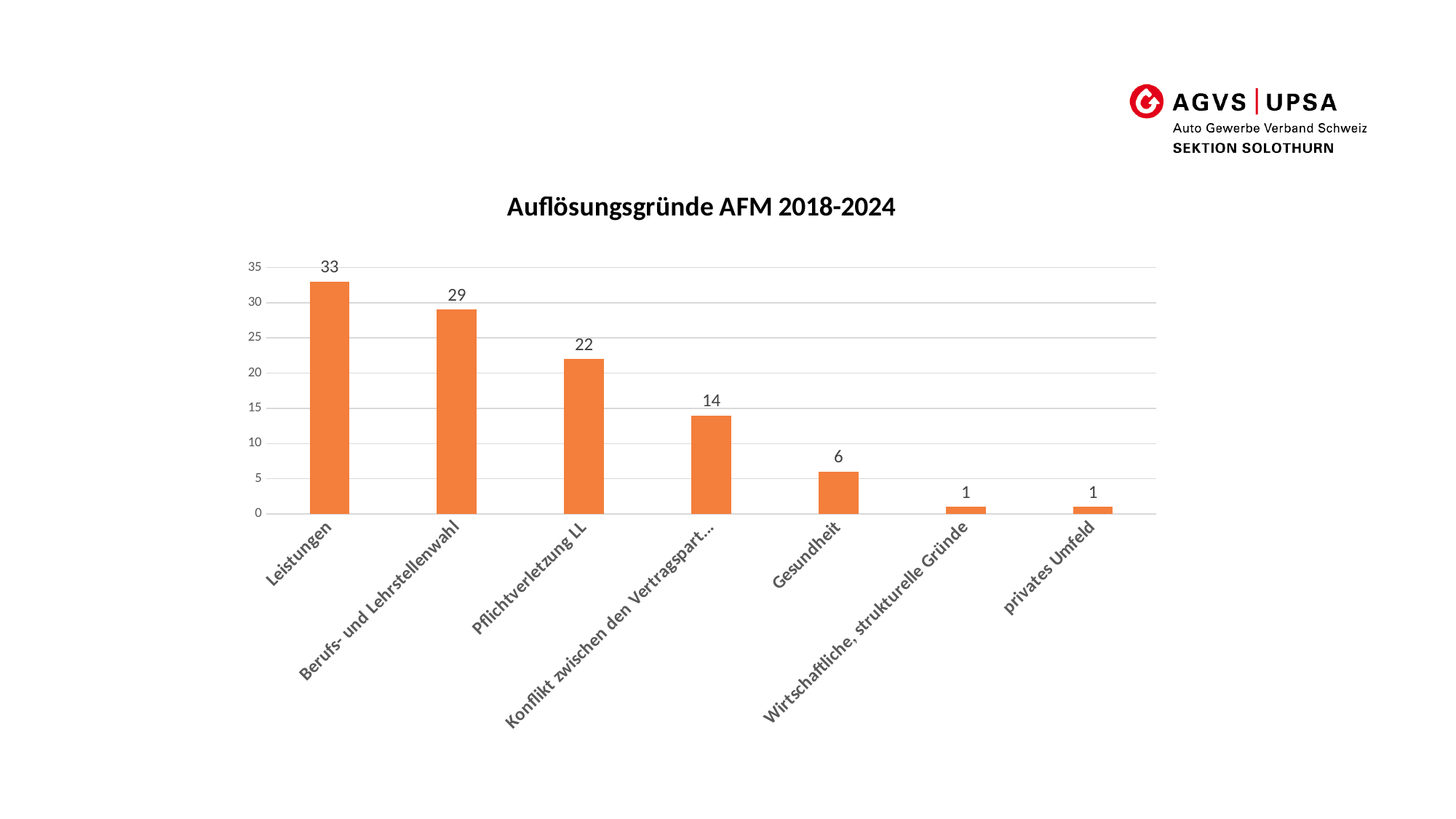
What is the value for privates Umfeld? 1 What is the difference between the values for Pflichtverletzung LL and Gesundheit? 16 What is the value for Pflichtverletzung LL? 22 Which is larger, the value for Pflichtverletzung LL or the value for Gesundheit? Pflichtverletzung LL Which category has the highest value? Leistungen What kind of chart is shown? Bar chart What is the value for Leistungen? 33 How many categories are shown on the x axis? 7 What is the value for Berufs- und Lehrstellenwahl? 29 What is the title of the chart? Auflösungsgründe AFM 2018-2024 What is the difference between the values for Leistungen and Berufs- und Lehrstellenwahl? 4 What is the value for Gesundheit? 6